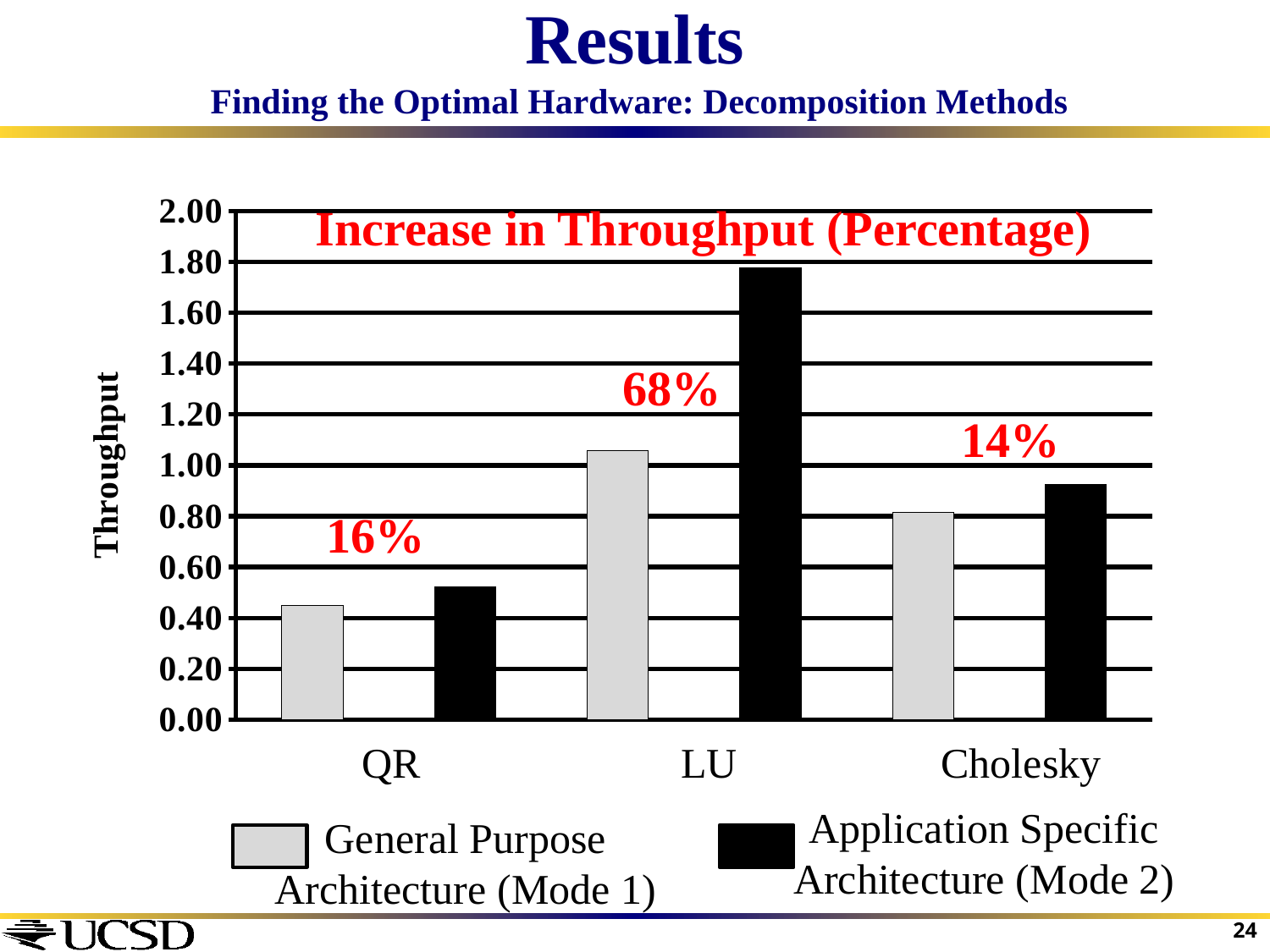
Which decomposition method has the smallest percentage increase in throughput? Cholesky How many decomposition methods are shown on the x axis? 3 Is the General Purpose Architecture (Mode 1) throughput for QR greater or less than 0.60? less What percentage increase in throughput is shown for QR? 16% Is the Application Specific Architecture (Mode 2) throughput for LU greater or less than 1.60? greater Which decomposition method has the largest percentage increase in throughput? LU How many series does the legend list? 2 What is the label on the y axis? Throughput Which decomposition method has the tallest Application Specific Architecture (Mode 2) bar? LU What kind of chart is shown on the slide? bar chart What percentage increase in throughput is shown for LU? 68% What percentage increase in throughput is shown for Cholesky? 14%